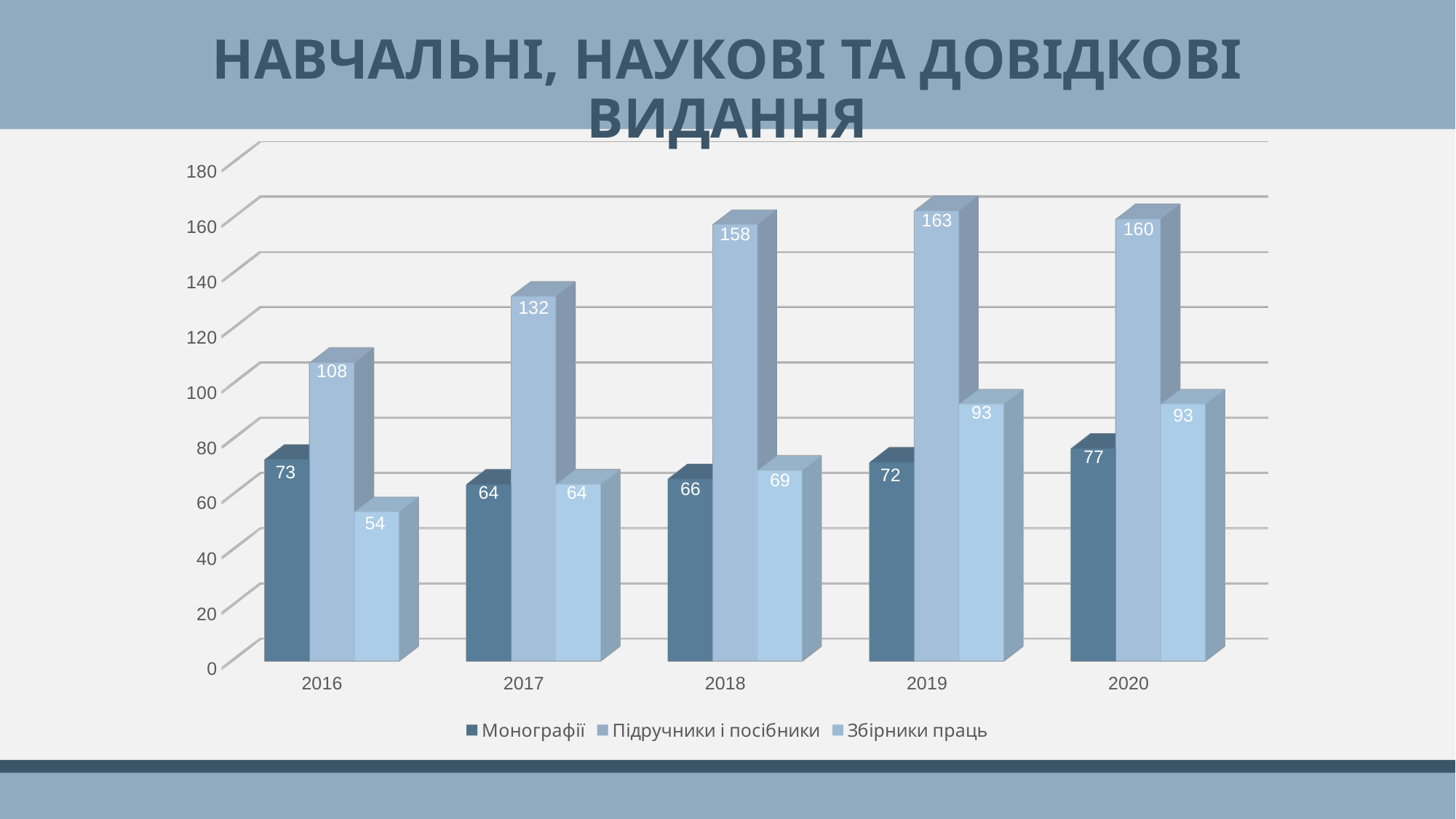
How many years are shown on the x axis? 5 What is the difference between the Підручники і посібники values for 2017 and 2016? 24 How many series does the legend list? 3 In which year is the value for Збірники праць lowest? 2016 Which is larger in 2019: Монографії or Збірники праць? Збірники праць In which year is the value for Підручники і посібники highest? 2019 What is the value for Підручники і посібники in 2018? 158 What is the value for Збірники праць in 2020? 93 What is the title of the slide? НАВЧАЛЬНІ, НАУКОВІ ТА ДОВІДКОВІ ВИДАННЯ What kind of chart is shown on the slide? Bar chart What is the value for Монографії in 2016? 73 Does the value for Підручники і посібники rise or fall from 2016 to 2019? Rise